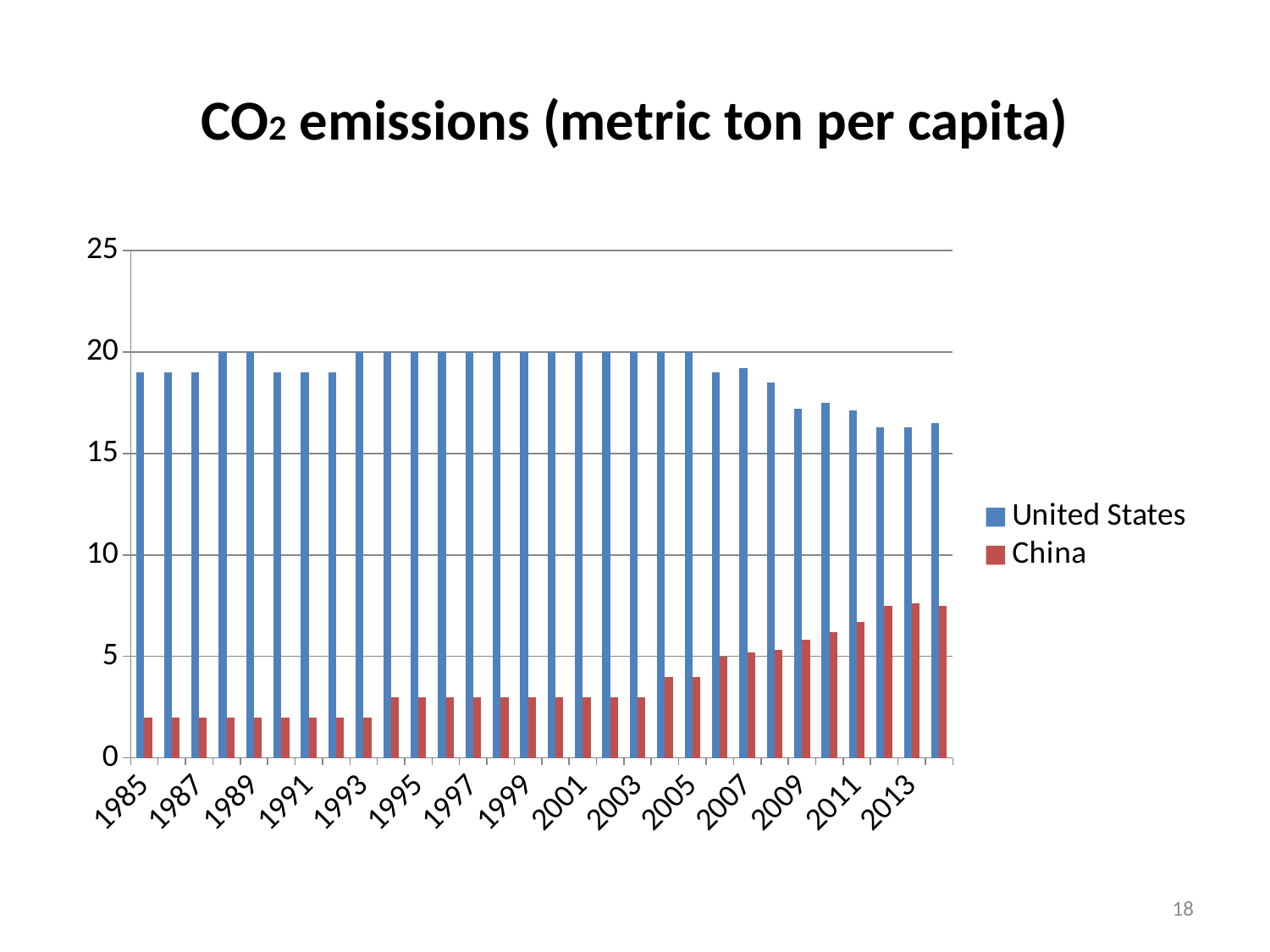
Is the value for China in 2013 greater or less than 5? greater How many series does the legend list? 2 In 2013, which is larger, the value for the United States or the value for China? United States Is the value for the United States in 2013 greater or less than 20? less What is the title of the chart? CO2 emissions (metric ton per capita) What kind of chart is shown on the slide? bar chart Is the value for China in 2013 greater or less than 10? less Do the values for the United States rise or fall from 2005 to 2013? fall Which series is shown in red? China Do the values for China rise or fall from 1985 to 2013? rise